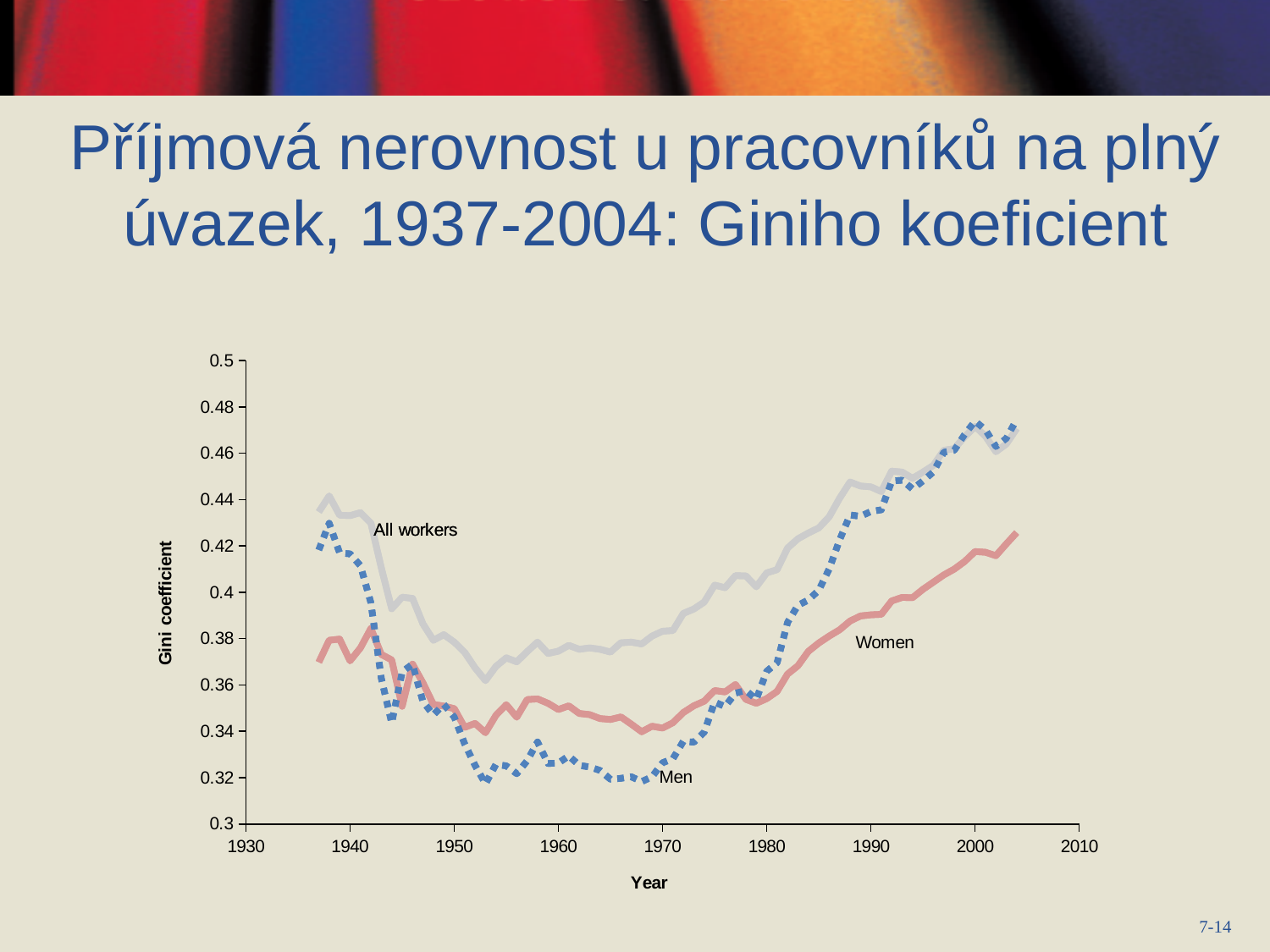
In 1960, which series has the higher value, Women or Men? Women Which series has the lowest value around 1965? Men Is the value for Women around 1970 greater or less than 0.36? less How many series are plotted on the chart? 3 Is the value for All workers in 2000 greater or less than 0.44? greater Does the Women series rise or fall between 1980 and 2004? rise In 1990, which series has the higher value, Men or Women? Men Is the value for Women in 2004 greater or less than 0.4? greater What kind of chart is shown on the slide? line chart What are the names of the three series plotted on the chart? All workers, Men, Women What is the title of the vertical axis? Gini coefficient